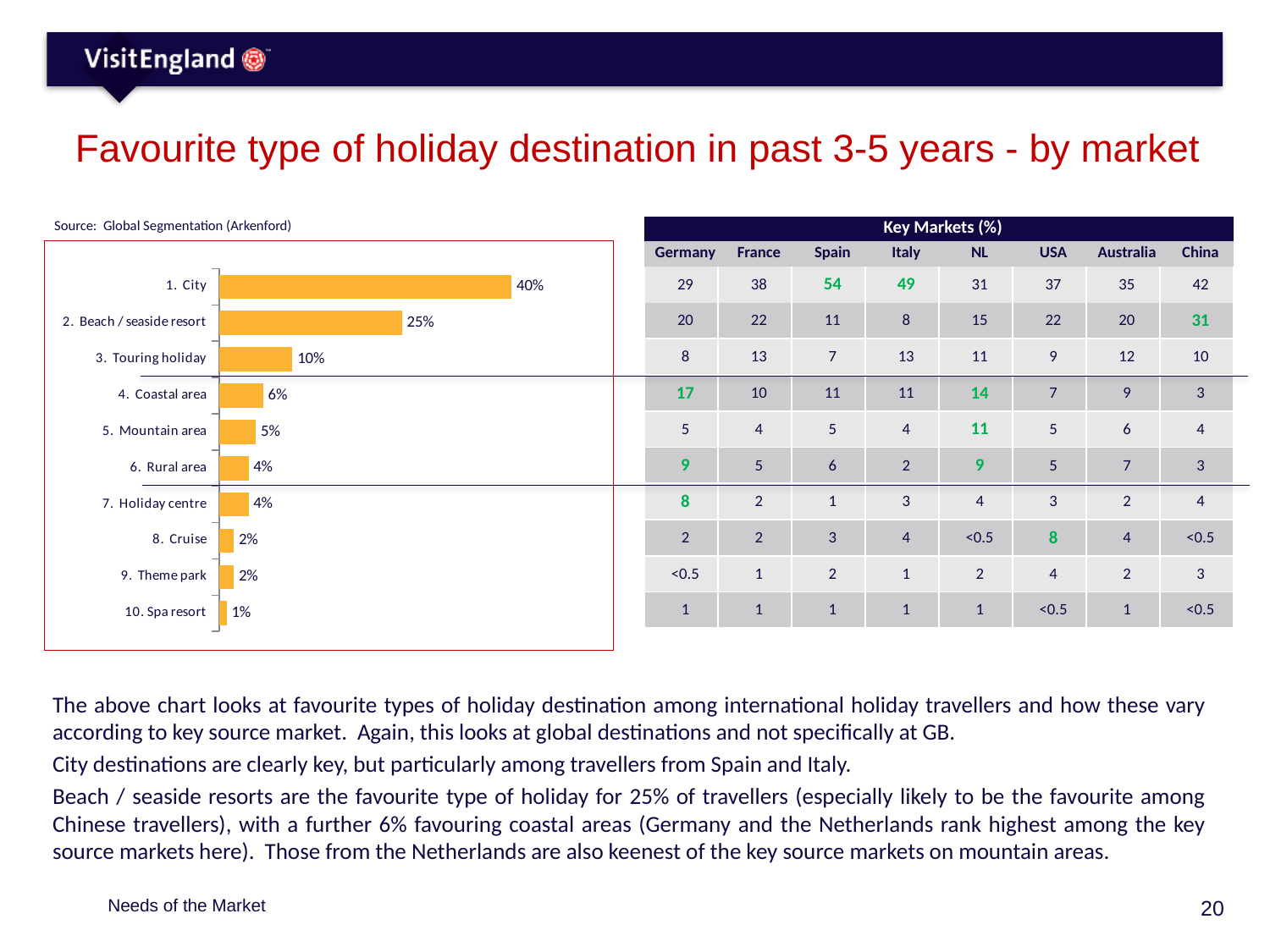
Which category has the lowest value in the bar chart? Spa resort What is the difference between the values for City and Beach / seaside resort in the bar chart? 15% What is the value for Mountain area in the bar chart? 5% Do the bar values rise or fall going from the top category to the bottom category of the bar chart? Fall Which is larger in the bar chart, the value for Coastal area or the value for Cruise? Coastal area What is the value for City in the bar chart? 40% Which category has the highest value in the bar chart? City How many categories are shown in the bar chart? 10 What kind of chart is shown on the left of the slide? Bar chart What is the difference between the values for Touring holiday and Coastal area in the bar chart? 4% What is the value for Touring holiday in the bar chart? 10% What is the value for Beach / seaside resort in the bar chart? 25%